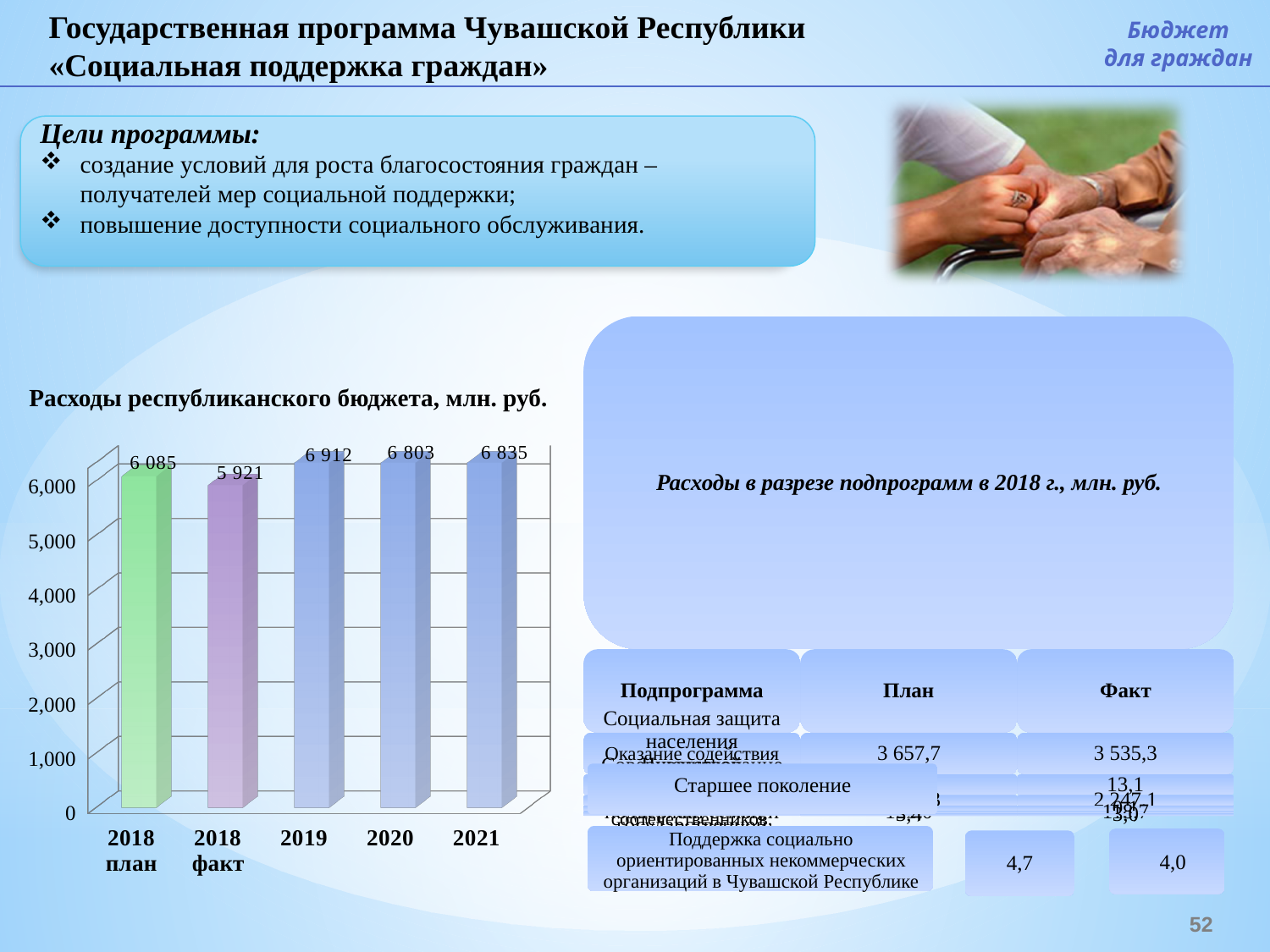
In the chart 'Расходы республиканского бюджета, млн. руб.', is the value for 2018 факт greater or less than 6,000? less How many bars are shown in the chart 'Расходы республиканского бюджета, млн. руб.'? 5 What type of chart is 'Расходы республиканского бюджета, млн. руб.'? bar chart Which category has the highest value in the chart 'Расходы республиканского бюджета, млн. руб.'? 2019 In the chart 'Расходы республиканского бюджета, млн. руб.', which is larger: the value for 2020 or the value for 2021? 2021 What is the value for 2018 факт in the chart 'Расходы республиканского бюджета, млн. руб.'? 5 921 What is the title of the bar chart on the left side of the slide? Расходы республиканского бюджета, млн. руб. Which category has the lowest value in the chart 'Расходы республиканского бюджета, млн. руб.'? 2018 факт What is the difference between the 2018 план and 2018 факт values in the chart 'Расходы республиканского бюджета, млн. руб.'? 164 What is the value for 2018 план in the chart 'Расходы республиканского бюджета, млн. руб.'? 6 085 What is the value for 2019 in the chart 'Расходы республиканского бюджета, млн. руб.'? 6 912 What is the value for 2021 in the chart 'Расходы республиканского бюджета, млн. руб.'? 6 835